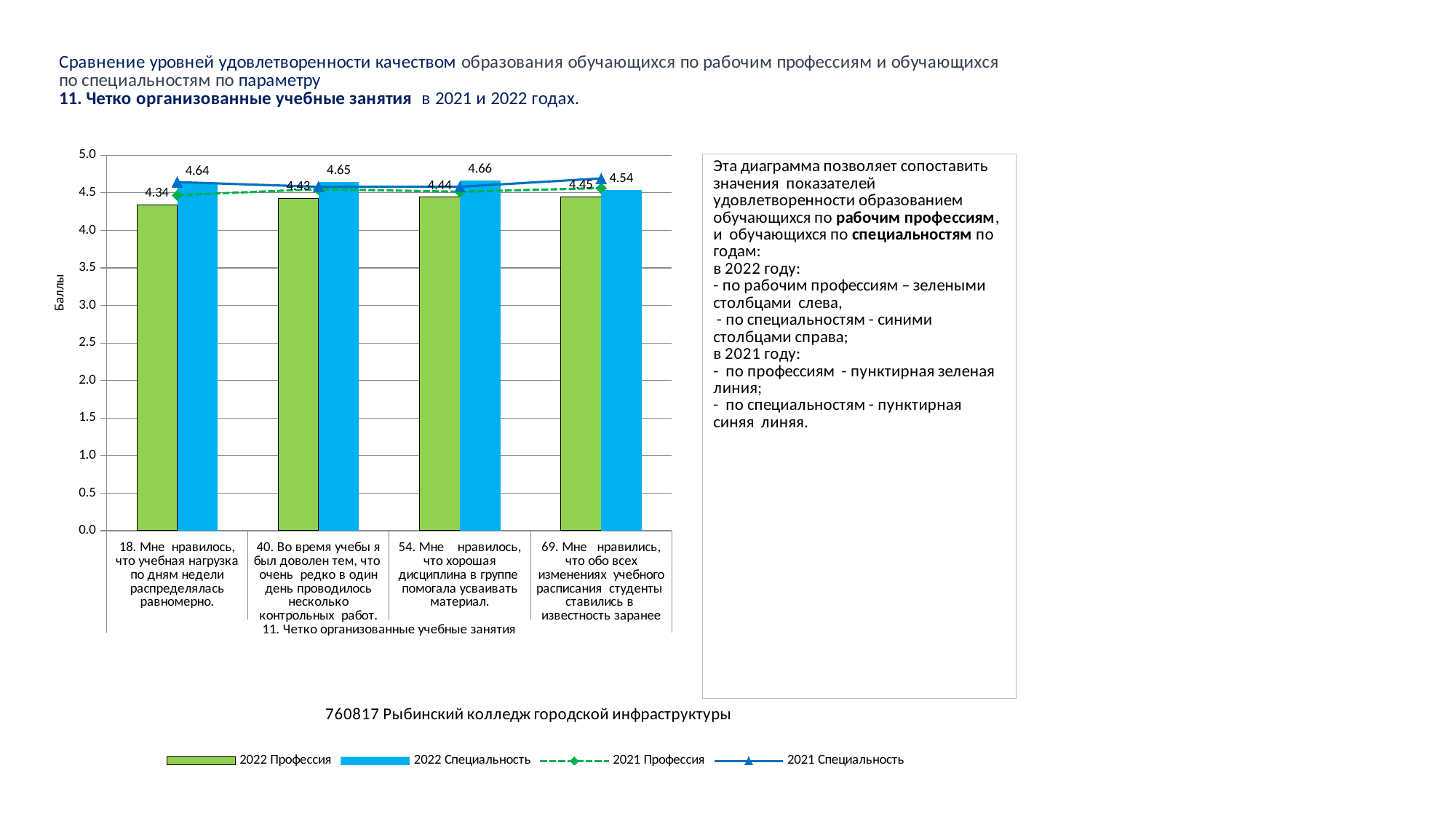
What is the label of the vertical axis? Баллы For category 69, which 2022 bar is larger: Профессия or Специальность? Специальность Which category has the highest 2022 Специальность bar? 54. Мне нравилось, что хорошая дисциплина в группе помогала усваивать материал. What is the difference between the 2022 Специальность and 2022 Профессия bars for category 18? 0.30 Do the 2022 Профессия bar values rise or fall from left to right across the categories? rise What is the value of the 2022 Специальность bar for category 69 (Мне нравились, что обо всех изменениях учебного расписания студенты ставились в известность заранее)? 4.54 How many series does the legend list? 4 What is the value of the 2022 Профессия bar for category 18 (Мне нравилось, что учебная нагрузка по дням недели распределялась равномерно)? 4.34 Is the 2022 Профессия value for category 40 greater or less than 4.5? less How many categories are shown on the x axis? 4 What is the value of the 2022 Специальность bar for category 54 (Мне нравилось, что хорошая дисциплина в группе помогала усваивать материал)? 4.66 Which category has the lowest 2022 Профессия bar? 18. Мне нравилось, что учебная нагрузка по дням недели распределялась равномерно.